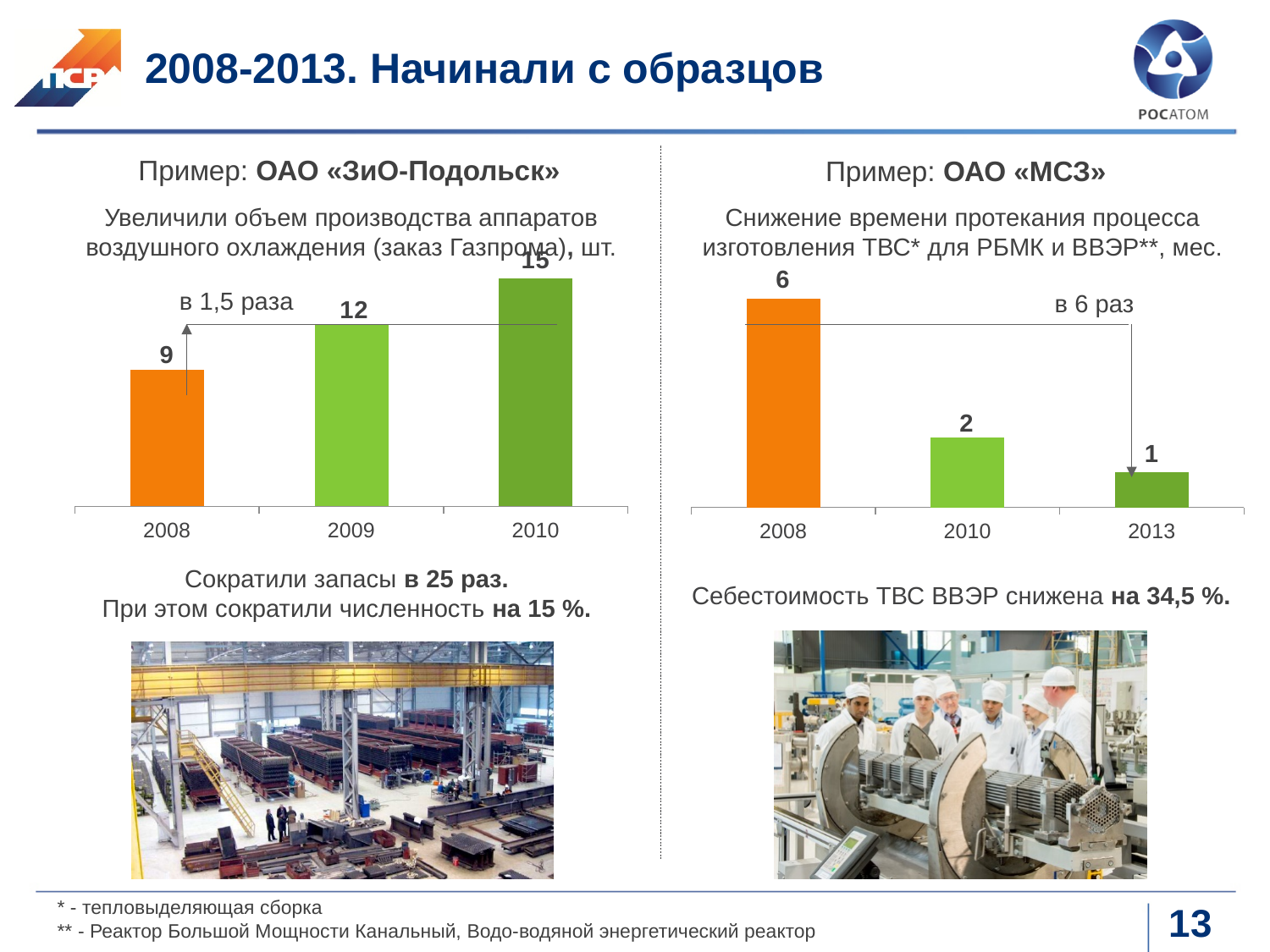
In the right chart (ОАО «МСЗ»), what is the value for 2008? 6 In the left chart (ОАО «ЗиО-Подольск»), how many years are shown? 3 In the right chart (ОАО «МСЗ»), which year has the lowest value? 2013 In the right chart (ОАО «МСЗ»), what is the difference between the values for 2008 and 2013? 5 In the left chart (ОАО «ЗиО-Подольск»), what is the difference between the values for 2010 and 2008? 6 In the right chart (ОАО «МСЗ»), do the values rise or fall from 2008 to 2013? fall In the left chart (ОАО «ЗиО-Подольск»), do the values rise or fall from 2008 to 2010? rise In the left chart (ОАО «ЗиО-Подольск»), what colour is the bar for 2008? orange In the right chart (ОАО «МСЗ»), which is larger, the value for 2010 or the value for 2013? 2010 In the left chart (ОАО «ЗиО-Подольск»), what is the value for 2009? 12 In the left chart (ОАО «ЗиО-Подольск»), which year has the highest value? 2010 What type of chart is the right chart (ОАО «МСЗ»)? bar chart